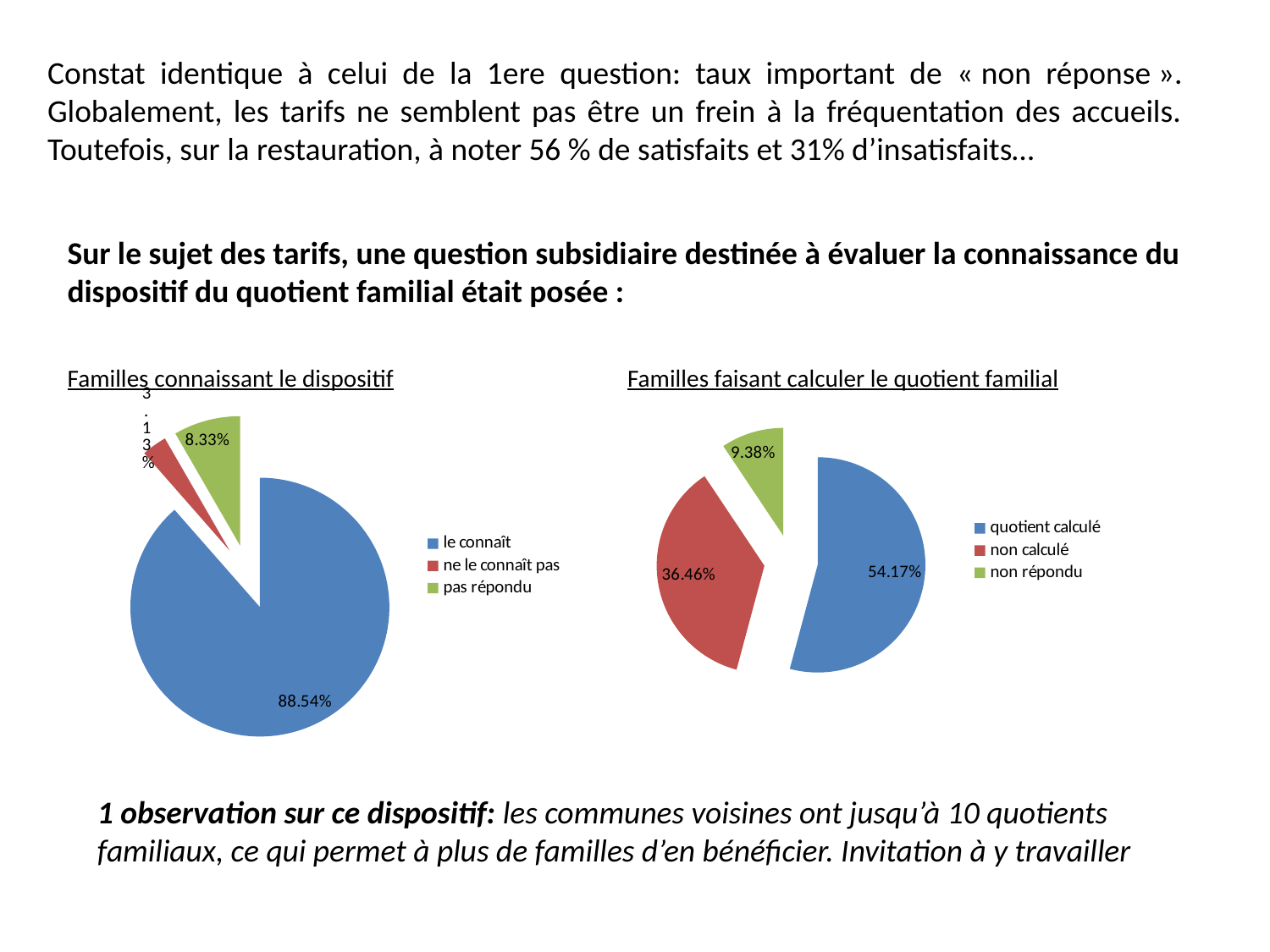
In the 'Familles connaissant le dispositif' chart, which category has the largest slice? le connaît In the 'Familles faisant calculer le quotient familial' chart, what is the value for 'quotient calculé'? 54.17% In the 'Familles faisant calculer le quotient familial' chart, what is the value for 'non répondu'? 9.38% In the 'Familles faisant calculer le quotient familial' chart, what is the difference between 'quotient calculé' and 'non calculé'? 17.71% In the 'Familles faisant calculer le quotient familial' chart, what is the value for 'non calculé'? 36.46% In the 'Familles connaissant le dispositif' chart, what is the value for 'pas répondu'? 8.33% In the 'Familles faisant calculer le quotient familial' chart, which category has the smallest slice? non répondu In the 'Familles connaissant le dispositif' chart, what is the value for 'le connaît'? 88.54% In the 'Familles connaissant le dispositif' chart, which category has the smallest slice? ne le connaît pas How many categories does the legend of the 'Familles connaissant le dispositif' chart list? 3 In the 'Familles faisant calculer le quotient familial' chart, what colour is the 'non calculé' slice? red What kind of chart is the 'Familles connaissant le dispositif' chart? pie chart